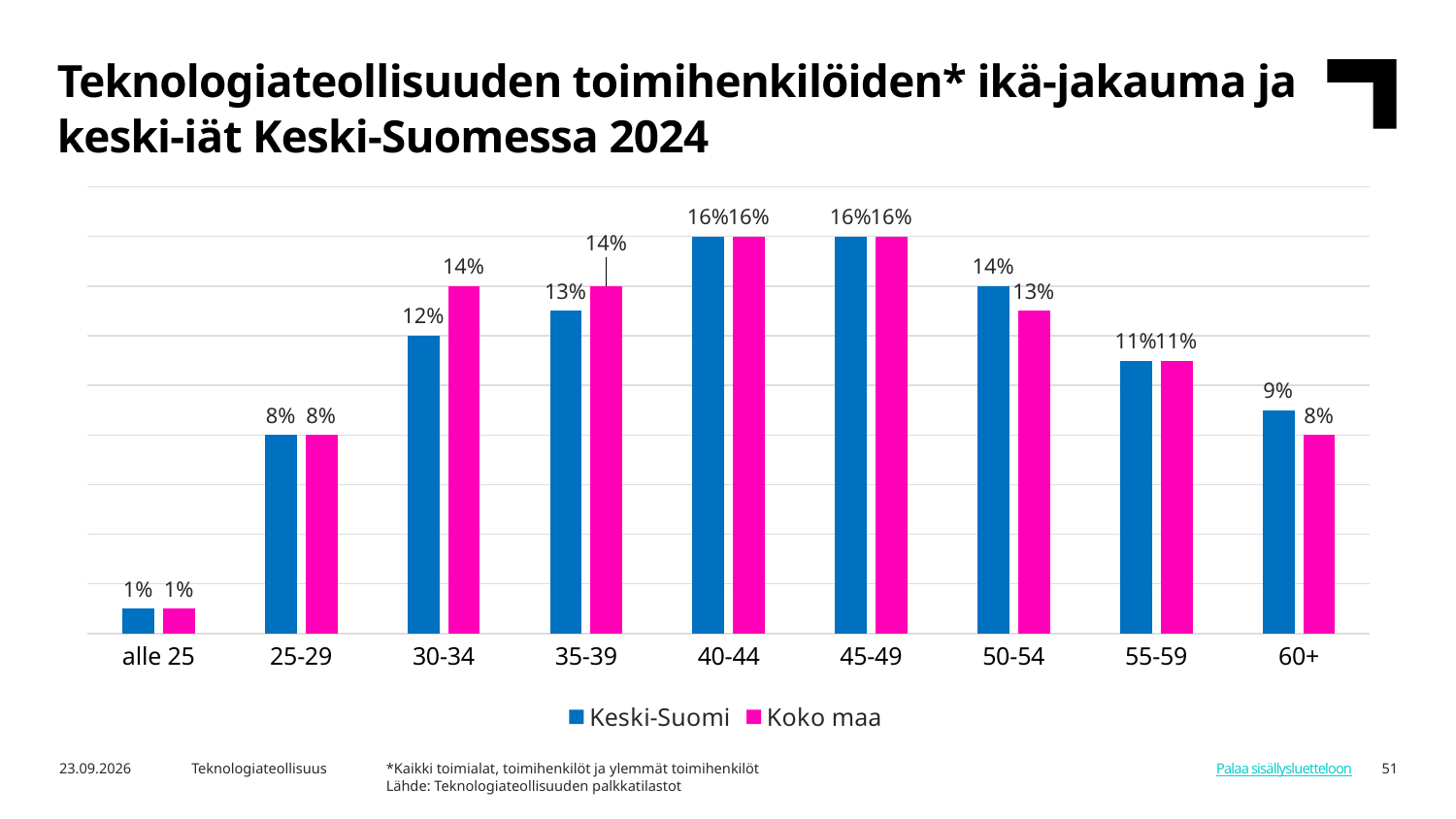
How many age groups are shown on the x axis? 9 How many series does the legend list? 2 What is the difference between the Keski-Suomi values for 45-49 and 50-54? 2% For the 50-54 age group, which series has the larger value, Keski-Suomi or Koko maa? Keski-Suomi What is the Koko maa value for the 50-54 age group? 13% Which age group has the lowest Keski-Suomi value? alle 25 For the 35-39 age group, which series has the larger value, Keski-Suomi or Koko maa? Koko maa What is the Keski-Suomi value for the 60+ age group? 9% What is the Koko maa value for the 35-39 age group? 14% What kind of chart is shown on the slide? Bar chart What is the Keski-Suomi value for the 30-34 age group? 12% What is the difference between the Koko maa and Keski-Suomi values for the 30-34 age group? 2%